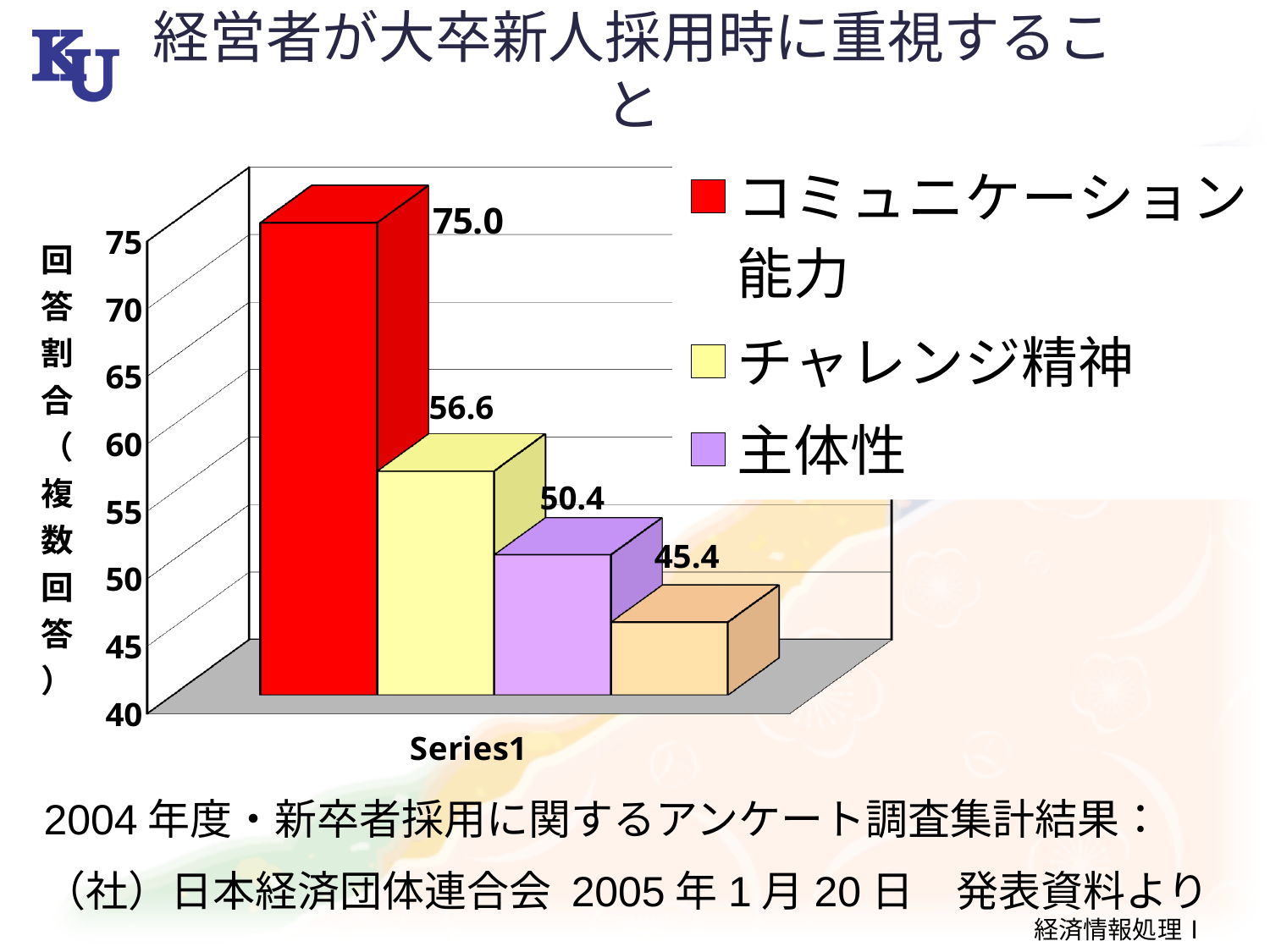
Which category has the highest value? コミュニケーション能力 Which is larger, the value for チャレンジ精神 or the value for 主体性? チャレンジ精神 What is the smallest data label shown on the chart? 45.4 What is the difference between the values for チャレンジ精神 and 主体性? 6.2 What is the value for 主体性? 50.4 How many bars are plotted on the chart? 4 What is the value for コミュニケーション能力? 75.0 What is the title of the vertical axis? 回答割合（複数回答） What is the value for チャレンジ精神? 56.6 What kind of chart is shown on the slide? bar chart How many entries does the legend list? 3 What is the difference between the values for コミュニケーション能力 and チャレンジ精神? 18.4